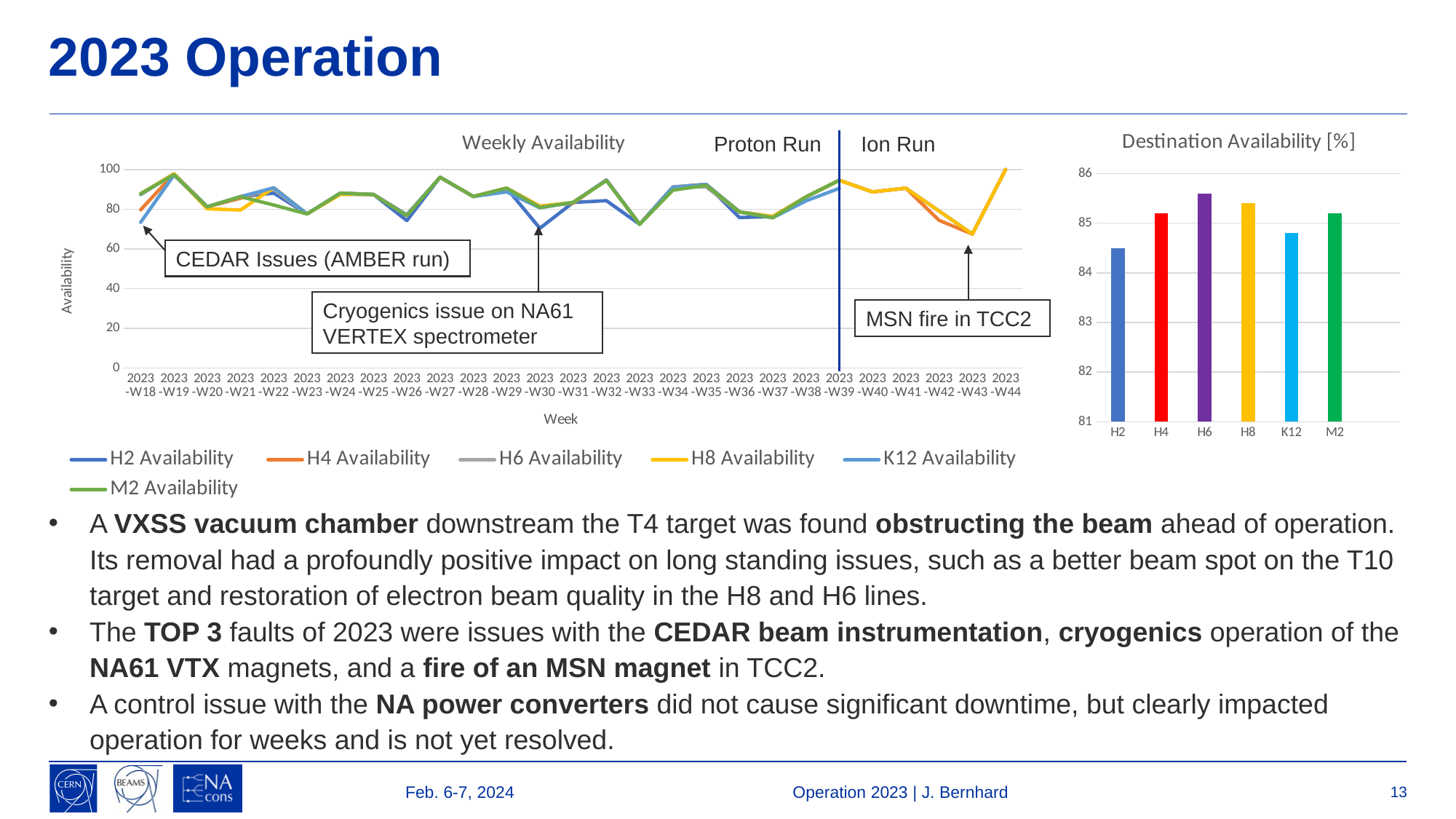
What kind of chart is the Weekly Availability chart? line chart In the Weekly Availability chart, is the availability in 2023-W43 greater or less than 80? less How many series does the legend of the Weekly Availability chart list? 6 What kind of chart is the Destination Availability [%] chart? bar chart In the Destination Availability [%] chart, is the value for H2 greater or less than 85? less In the Destination Availability [%] chart, which is larger, the value for H2 or the value for H6? H6 In the Destination Availability [%] chart, is the value for H6 greater or less than 85? greater How many destinations are shown in the Destination Availability [%] chart? 6 How many weeks are shown on the x axis of the Weekly Availability chart? 27 In the Destination Availability [%] chart, which destination has the highest availability? H6 In the Destination Availability [%] chart, which destination has the lowest availability? H2